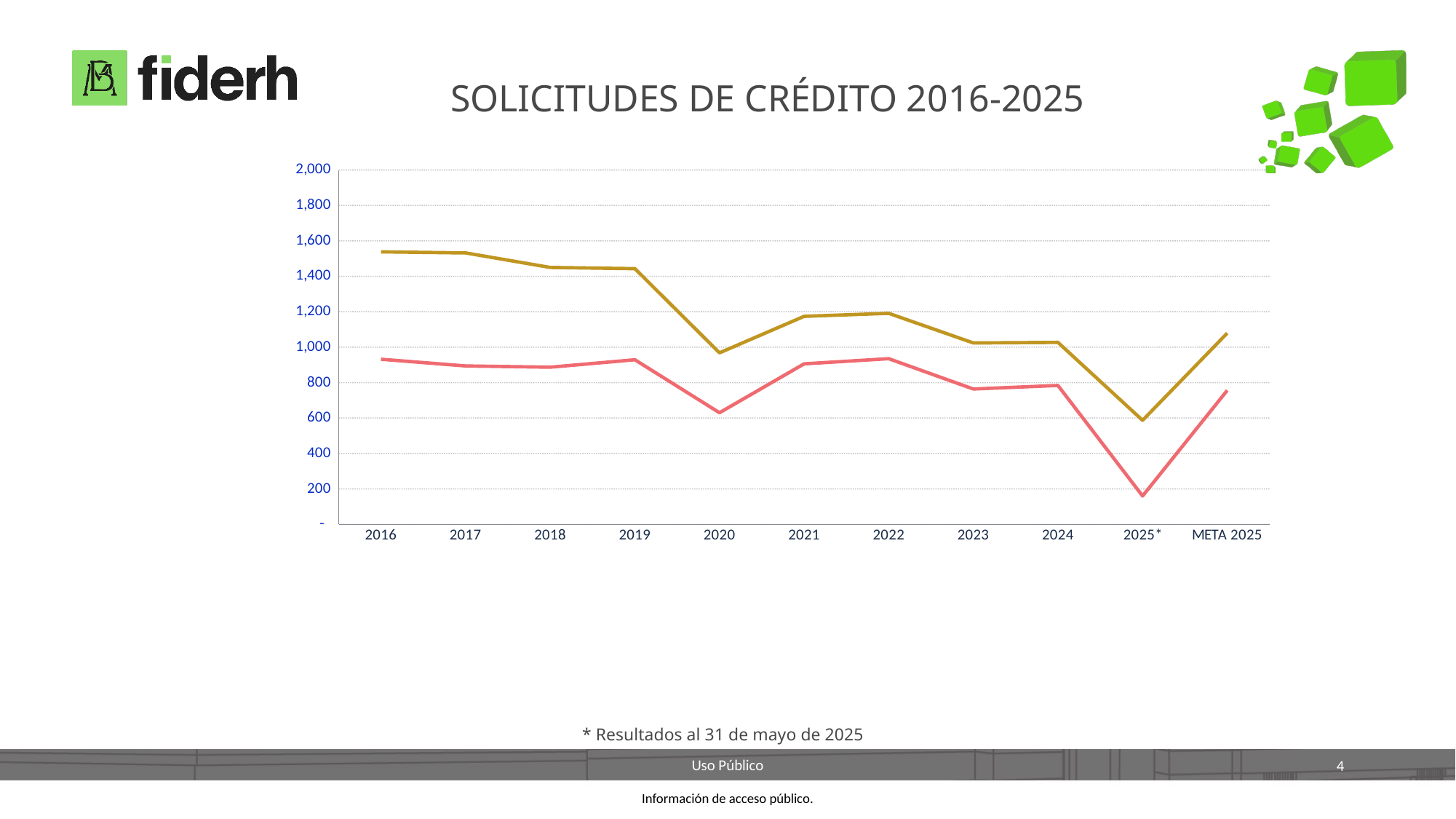
Is the value of the pink line for 2025* greater or less than 200? less Which line has the higher value in 2016, the gold line or the pink line? The gold line How many categories are shown on the x axis of the chart? 11 What kind of chart is shown on the slide? Line chart At which category does the pink line reach its lowest value? 2025* How many lines are plotted on the chart? 2 Is the value of the gold line for 2020 greater or less than 1,000? less Is the value of the gold line for META 2025 greater or less than 1,000? greater What is the title of the chart? SOLICITUDES DE CRÉDITO 2016-2025 At which category does the gold line reach its lowest value? 2025*